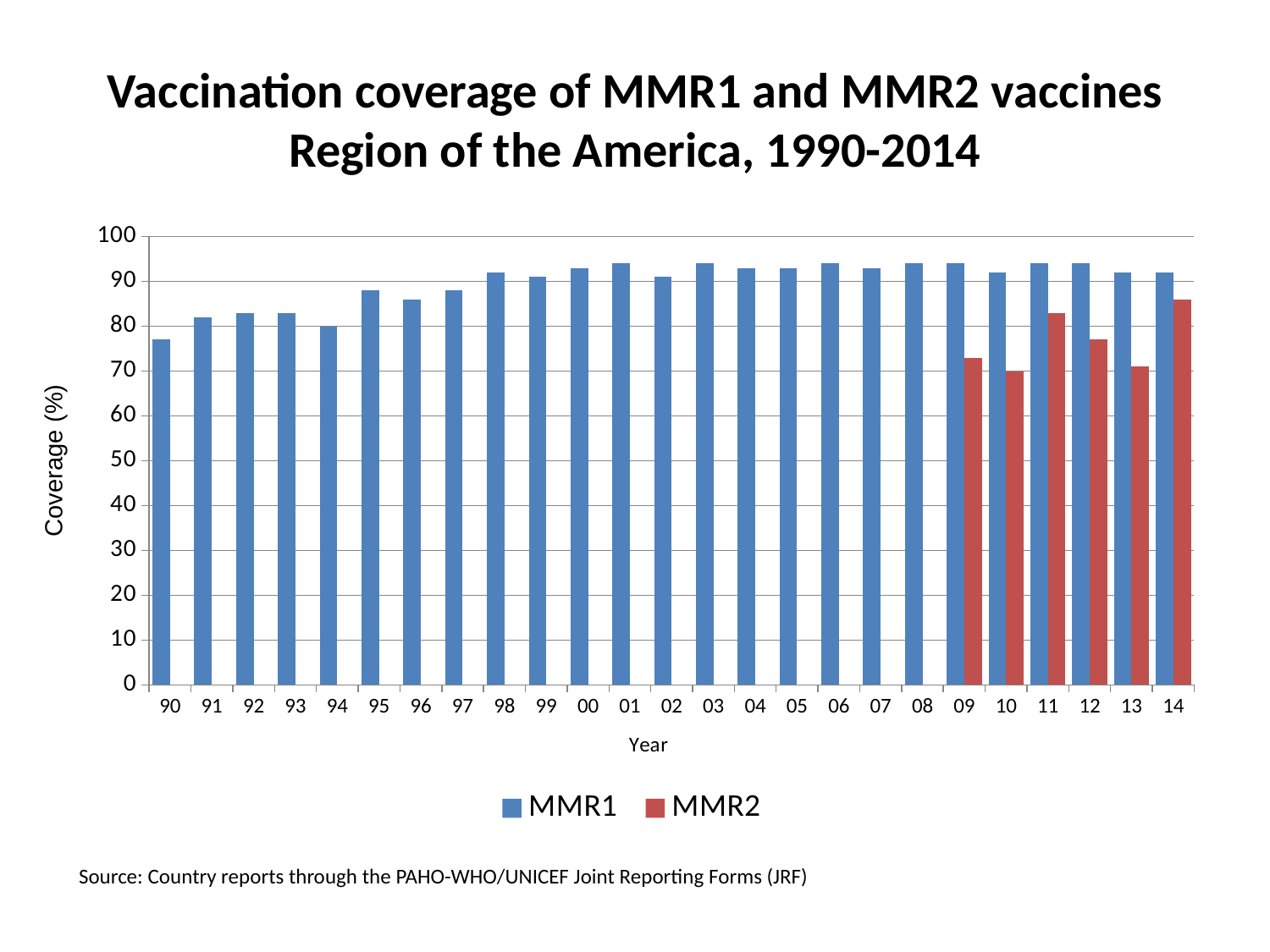
Is the MMR1 coverage for 95 greater or less than 80? greater Is the MMR2 coverage for 12 greater or less than 80? less Which year has the higher MMR2 coverage, 10 or 11? 11 Is the MMR1 coverage for 90 greater or less than 80? less How many series does the legend list? 2 What kind of chart is shown on the slide? bar chart Which year has the highest MMR2 coverage? 14 Does MMR1 coverage rise or fall from 90 to 95? rise Which year has the lowest MMR1 coverage? 90 How many years are shown on the x axis? 25 In 14, which series has the higher coverage, MMR1 or MMR2? MMR1